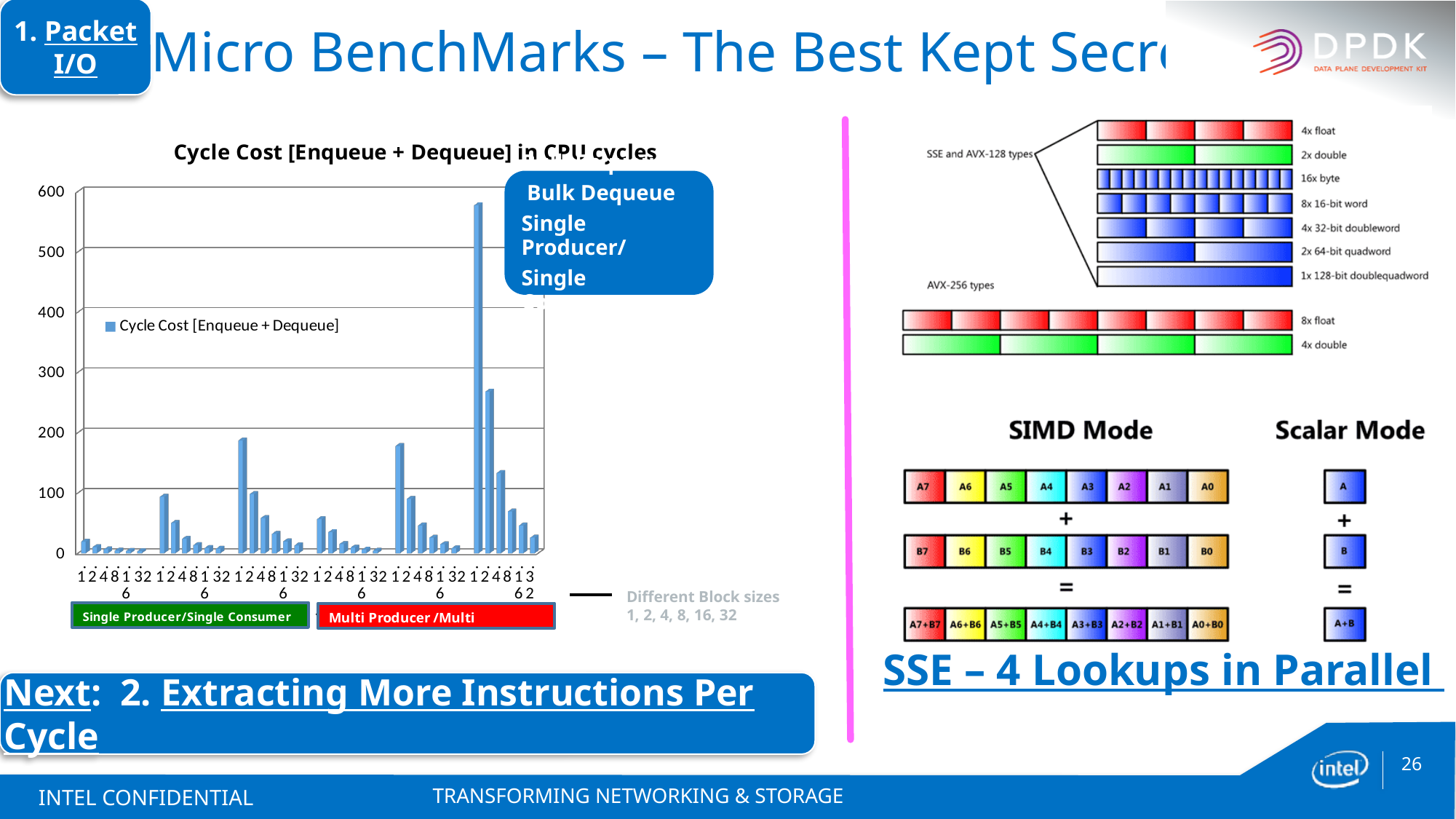
Is the value of the tallest bar in the chart greater or less than 500? greater Is the value of the tallest bar in the second group from the left greater or less than 200? less What is the name of the series shown in the chart's legend? Cycle Cost [Enqueue + Dequeue] Which block size has the highest cycle cost within each group: 1 or 32? 1 Within each group of block sizes, do the cycle cost values rise or fall as the block size increases from 1 to 32? fall Is the value of the tallest bar in the chart greater or less than 600? less How many series does the chart's legend list? 1 What kind of chart is shown on the slide? bar chart How many groups of block-size bars (1, 2, 4, 8, 16, 32) are plotted along the x axis? 6 What is the title of the chart on the slide? Cycle Cost [Enqueue + Dequeue] in CPU cycles What is the highest value shown on the chart's vertical axis? 600